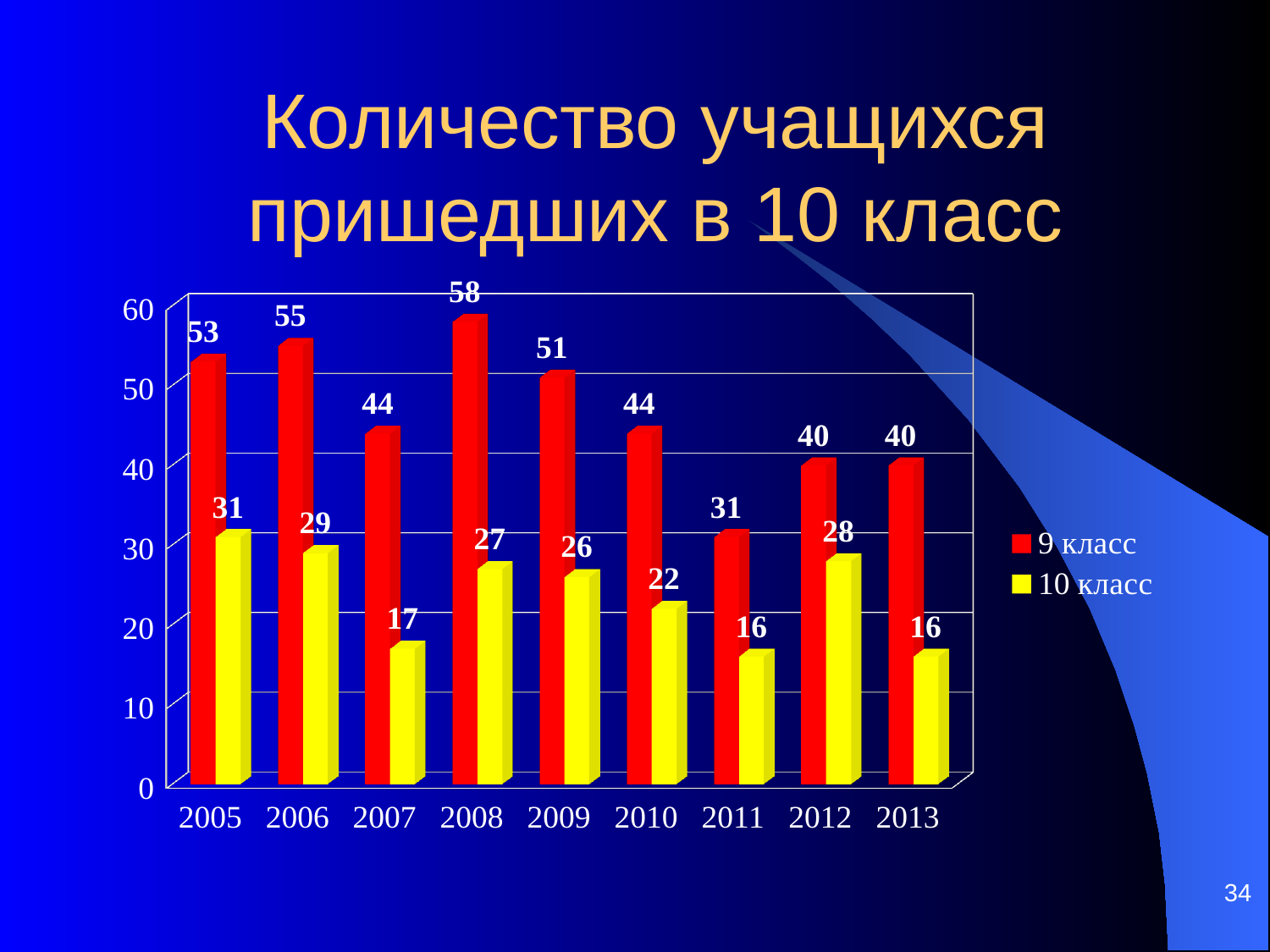
Which is larger: the 10 класс value in 2012 or in 2010? 2012 Which year has the lowest value for 10 класс? 2011 and 2013 What is the value for 10 класс in 2005? 31 Which colour represents 10 класс in the legend? yellow What is the value for 9 класс in 2008? 58 How many years are shown on the x axis? 9 What kind of chart is shown on the slide? bar chart Which year has the highest value for 9 класс? 2008 What is the difference between 9 класс and 10 класс in 2007? 27 How many series does the legend list? 2 What is the value for 10 класс in 2011? 16 What is the title of the chart? Количество учащихся пришедших в 10 класс